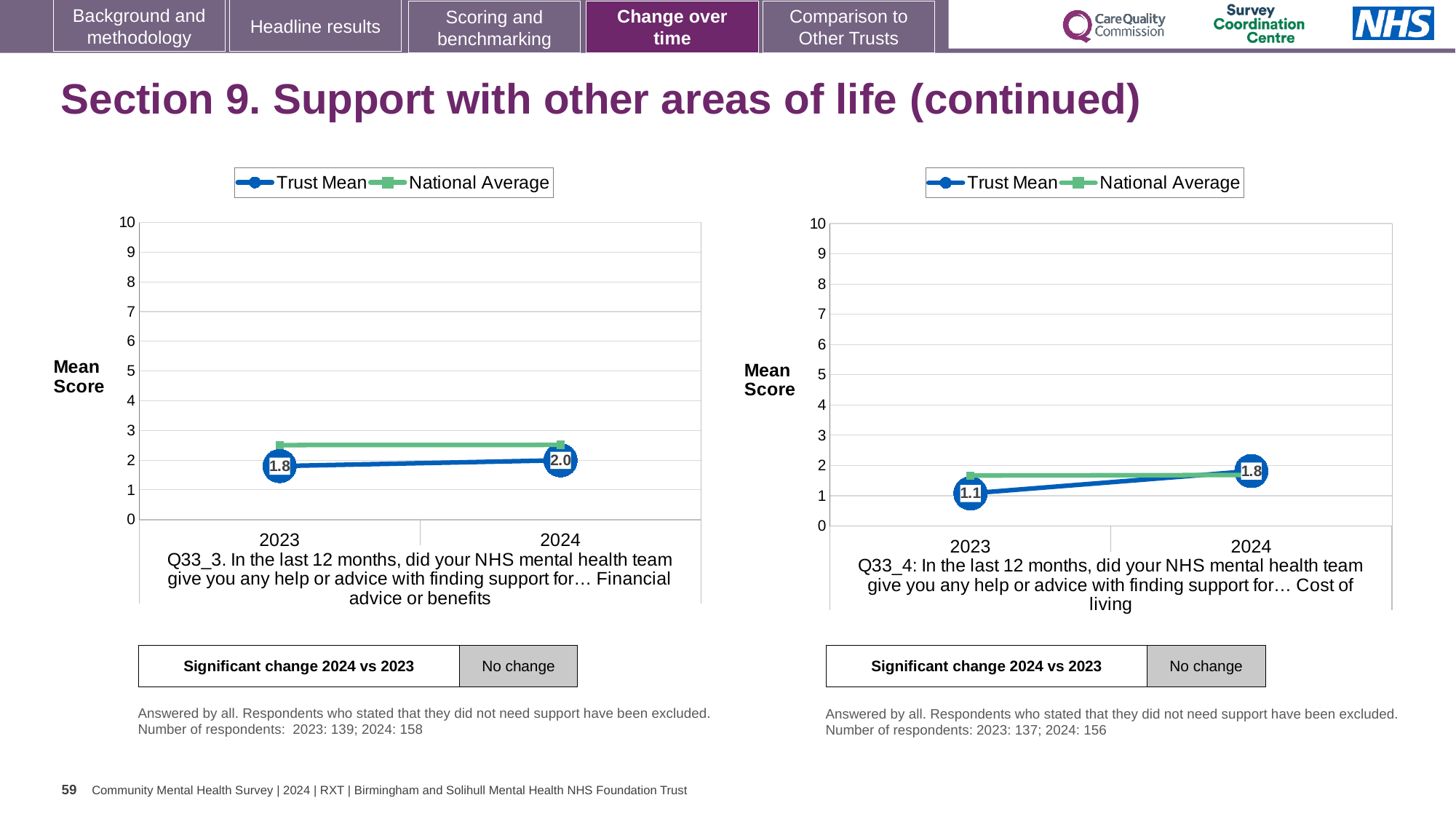
What kind of chart is the left chart (Q33_3, Financial advice or benefits)? line chart In the right chart (Q33_4, Cost of living), what is the Trust Mean score for 2023? 1.1 In the left chart (Q33_3, Financial advice or benefits), what is the Trust Mean score for 2023? 1.8 In the left chart (Q33_3, Financial advice or benefits), is the National Average for 2024 greater or less than 2? greater In the left chart (Q33_3, Financial advice or benefits), which is higher in 2024, the Trust Mean or the National Average? National Average In the left chart (Q33_3, Financial advice or benefits), what is the Trust Mean score for 2024? 2.0 How many series does the legend of the right chart (Q33_4, Cost of living) list? 2 In the left chart (Q33_3, Financial advice or benefits), does the Trust Mean rise or fall from 2023 to 2024? rise In the right chart (Q33_4, Cost of living), what is the Trust Mean score for 2024? 1.8 In the right chart (Q33_4, Cost of living), is the Trust Mean for 2023 greater or less than 2? less In the left chart (Q33_3, Financial advice or benefits), what is the difference between the Trust Mean for 2024 and 2023? 0.2 In the right chart (Q33_4, Cost of living), by how much did the Trust Mean change from 2023 to 2024? 0.7